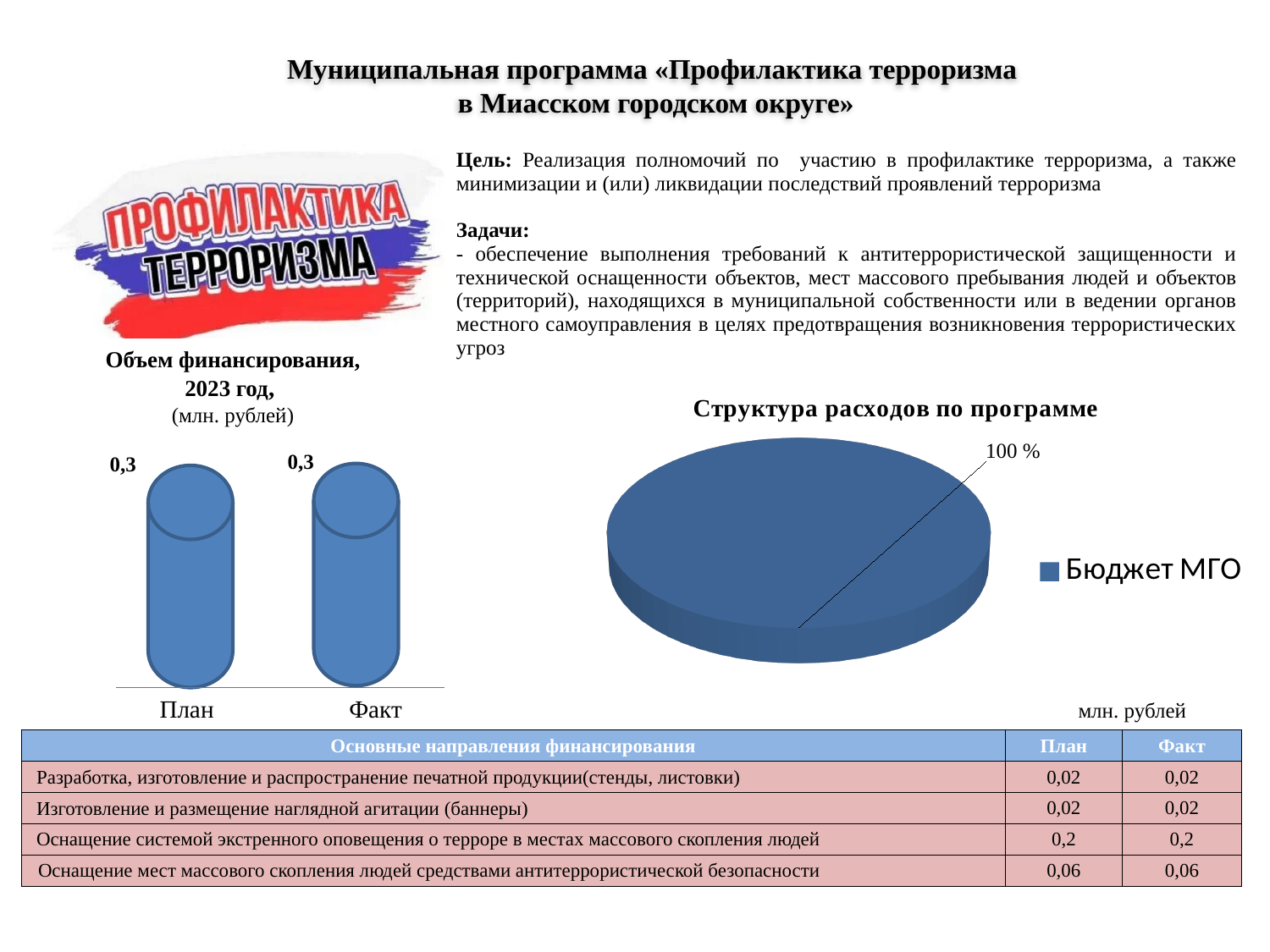
What kind of chart is the one titled «Структура расходов по программе»? Pie chart What kind of chart is the one titled «Объем финансирования, 2023 год»? Bar chart In the chart titled «Объем финансирования, 2023 год», what is the difference between the План and Факт values? 0 In the chart titled «Структура расходов по программе», what is the name of the only legend entry? Бюджет МГО In the chart titled «Структура расходов по программе», how many slices does the pie have? 1 In the chart titled «Структура расходов по программе», how many entries does the legend list? 1 In the chart titled «Объем финансирования, 2023 год», what unit is given in the title? млн. рублей In the chart titled «Объем финансирования, 2023 год», what is the value for План? 0,3 In the chart titled «Объем финансирования, 2023 год», how many categories are shown on the x axis? 2 In the chart titled «Структура расходов по программе», what share does the slice «Бюджет МГО» have? 100 % In the chart titled «Объем финансирования, 2023 год», what is the value for Факт? 0,3